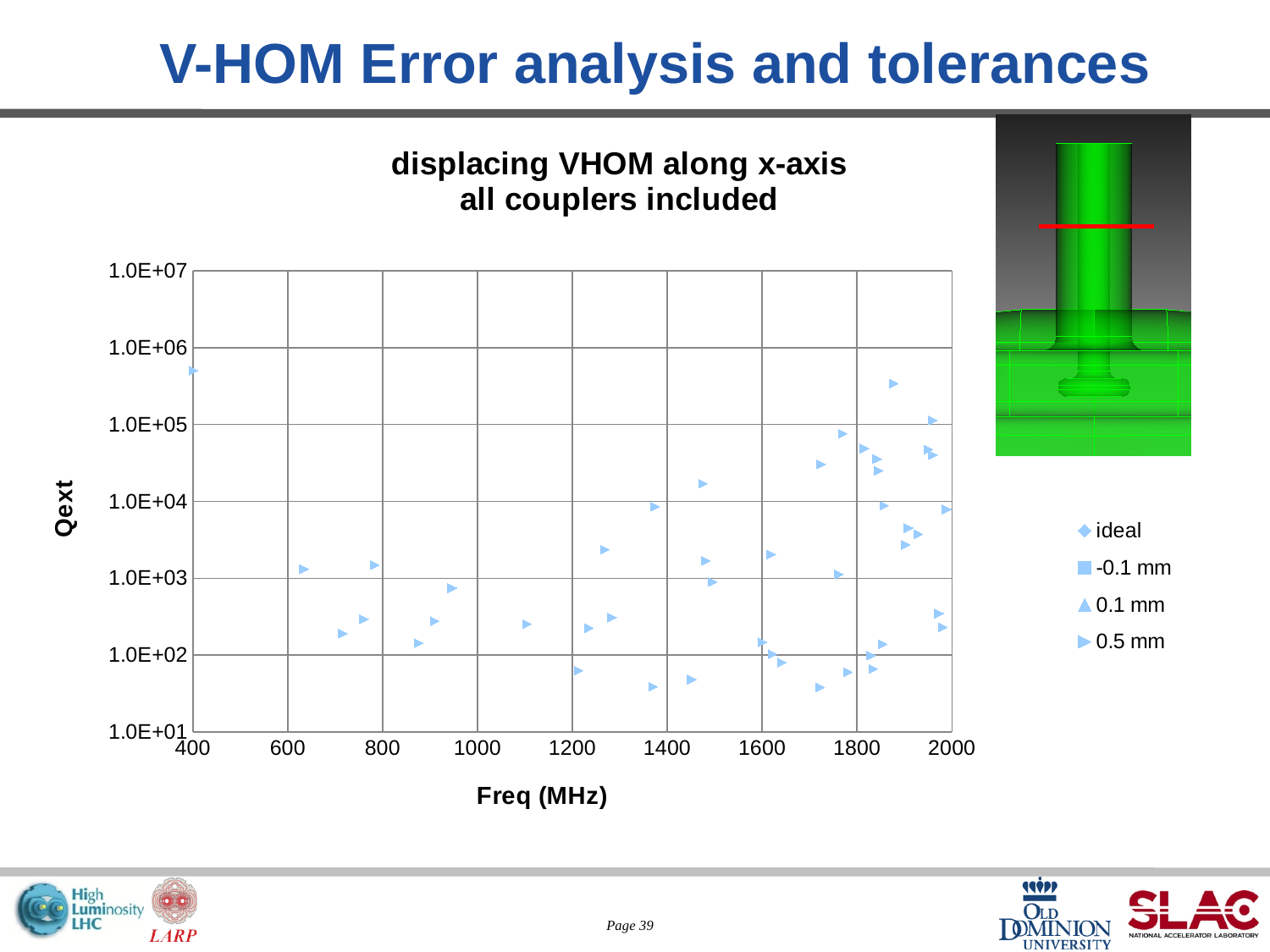
Is the Qext value of the point plotted at about 400 MHz greater or less than 1.0E+05? greater What are the four series named in the legend? ideal, -0.1 mm, 0.1 mm, 0.5 mm What kind of chart is shown on the slide? scatter chart How many series does the legend list? 4 Is the lowest Qext value plotted on the chart greater or less than 1.0E+02? less What is the title of the chart? displacing VHOM along x-axis all couplers included Is the highest Qext value plotted on the chart greater or less than 1.0E+05? greater